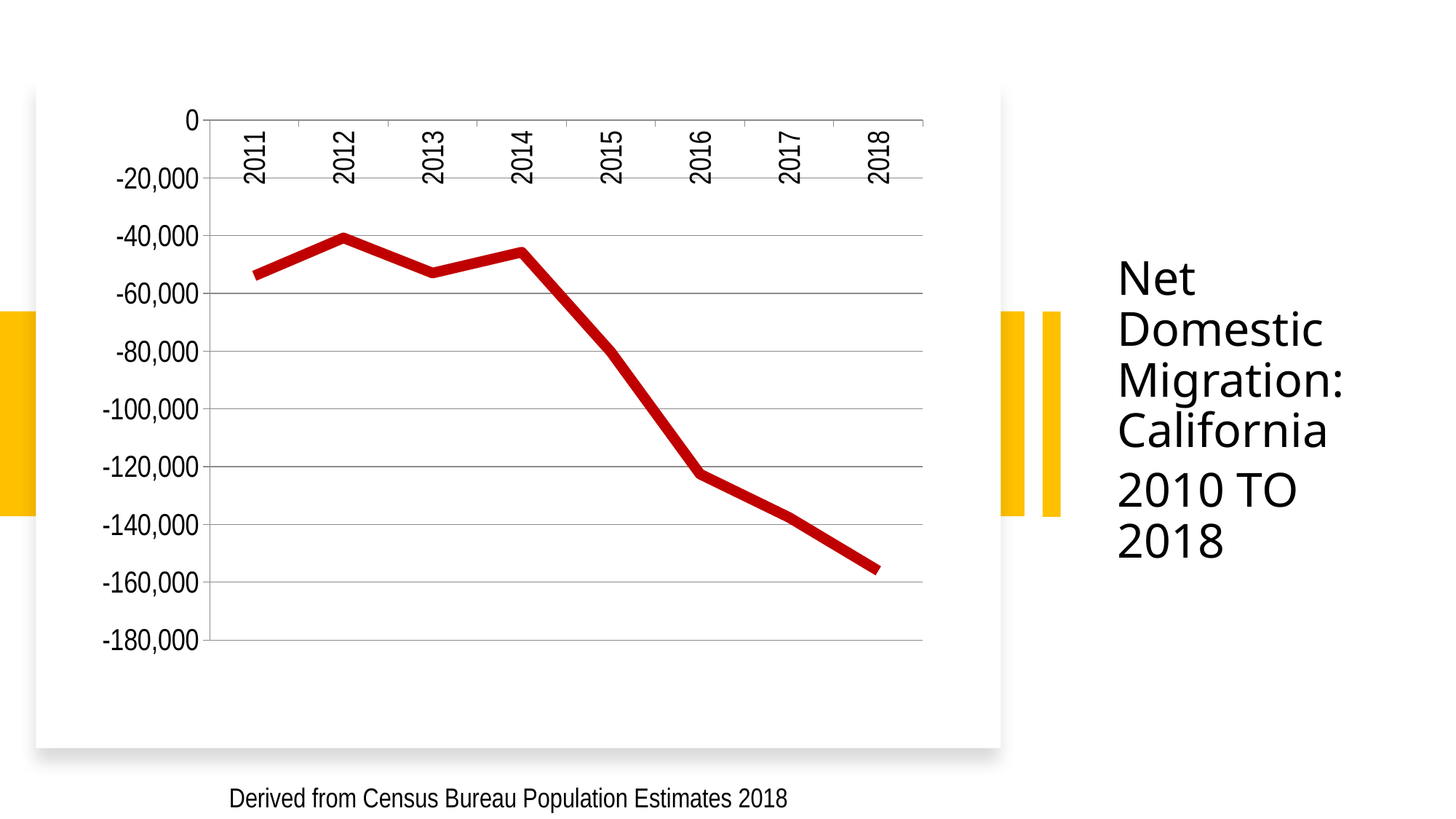
Is the value for 2015 greater or less than -100,000? greater What is the title shown next to the chart? Net Domestic Migration: California 2010 TO 2018 What kind of chart is shown on the slide? line chart Which year has the higher value, 2014 or 2017? 2014 Is the value for 2012 greater or less than -60,000? greater Which year has the lowest (most negative) net domestic migration value? 2018 Is the value for 2016 greater or less than -100,000? less How many years are plotted on the x axis of the chart? 8 Which year has the highest (least negative) net domestic migration value? 2012 Overall, do the values rise or fall from 2014 to 2018? fall Which year has the higher value, 2012 or 2018? 2012